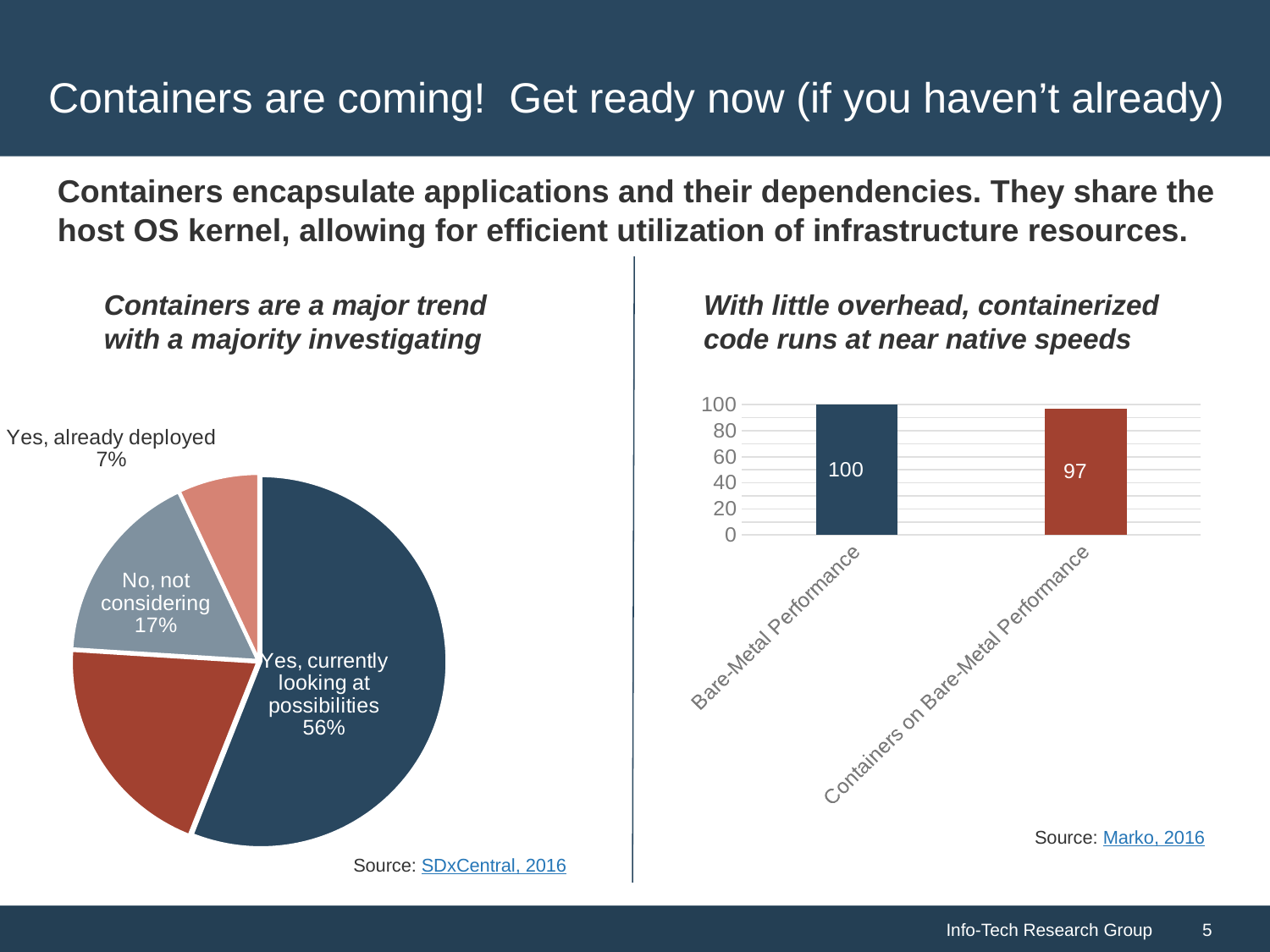
On the left pie chart, what percentage are not considering containers? 17% On the left pie chart, which slice is the largest? Yes, currently looking at possibilities How many slices does the left pie chart have? 4 On the right bar chart, what is the value for Containers on Bare-Metal Performance? 97 On the right bar chart, what is the difference between Bare-Metal Performance and Containers on Bare-Metal Performance? 3 On the left pie chart, what share of respondents are currently looking at possibilities? 56% On the right bar chart, what is the value for Bare-Metal Performance? 100 On the left pie chart, what percentage have already deployed containers? 7% On the left pie chart, how many percentage points larger is 'Yes, currently looking at possibilities' than 'No, not considering'? 39 What kind of chart is shown on the right side of the slide? Bar chart On the right bar chart, is the value for Containers on Bare-Metal Performance greater or less than 80? greater On the left pie chart, which labelled slice is the smallest? Yes, already deployed